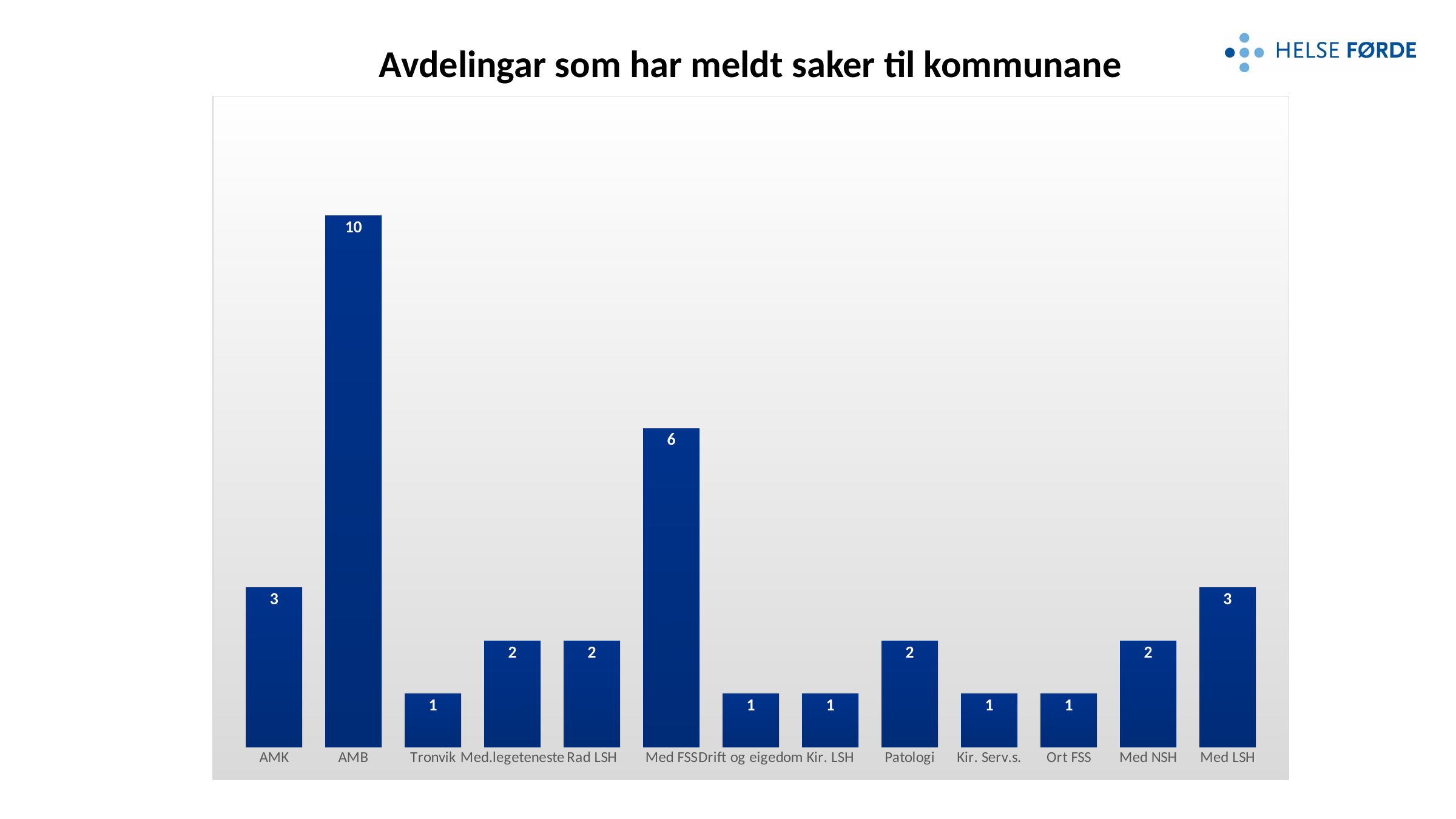
What is the difference between the values for AMK and Tronvik? 2 What is the difference between the values for AMB and Med FSS? 4 What is the value for AMB? 10 How many categories are shown in the chart? 13 What is the title of the chart? Avdelingar som har meldt saker til kommunane What is the value for Drift og eigedom? 1 What is the value for Med FSS? 6 What is the value for Med LSH? 3 What kind of chart is shown on the slide? Bar chart Which category has the highest value? AMB What is the value for Patologi? 2 Which is larger, the value for Med NSH or the value for Med LSH? Med LSH